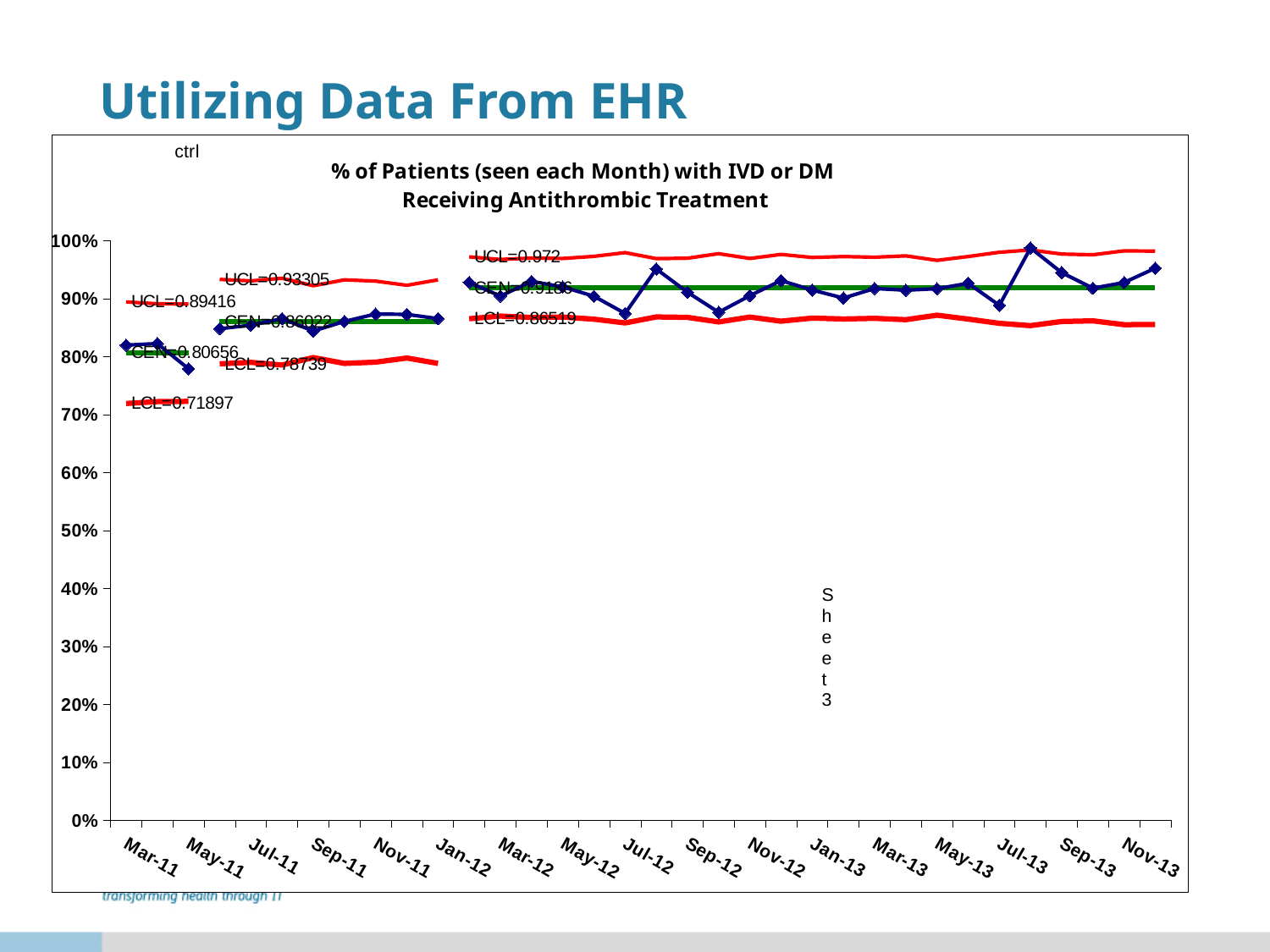
What is the title of the chart? % of Patients (seen each Month) with IVD or DM Receiving Antithrombic Treatment What is the LCL value labeled for the first control-limit segment (starting at Mar-11)? LCL=0.71897 What is the LCL value labeled for the last control-limit segment (from Jan-12 onward)? LCL=0.86519 What is the CEN value labeled for the first control-limit segment (starting at Mar-11)? CEN=0.80656 What is the UCL value labeled for the middle control-limit segment (around Jul-11 to Nov-11)? UCL=0.93305 What is the UCL value labeled for the last control-limit segment (from Jan-12 onward)? UCL=0.972 What type of chart is shown on the slide? line chart What is the UCL value labeled for the first control-limit segment (starting at Mar-11)? UCL=0.89416 Which is larger, the plotted value for Jul-13 or for Mar-11? Jul-13 Which month has the highest plotted value? Aug-13 Is the plotted value for Mar-11 greater or less than 90%? less